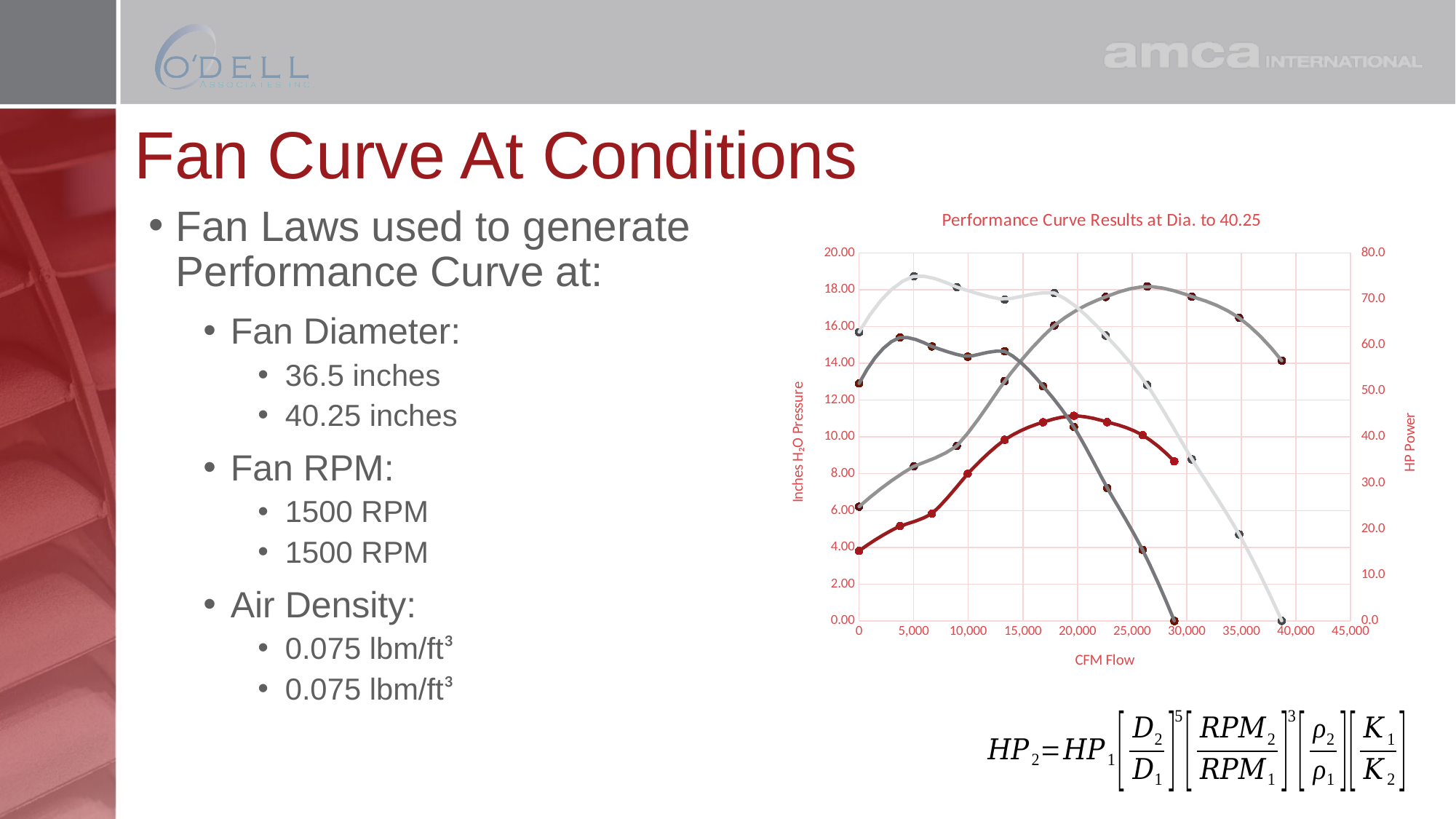
What is the highest value shown on the right vertical axis (HP Power)? 80.0 Does the dark red line end before or after the 30,000 CFM Flow gridline? before Does the dark red line rise or fall between 20,000 and 25,000 CFM Flow? fall Does the dark red line rise or fall between 0 and 15,000 CFM Flow? rise What is the title of the chart? Performance Curve Results at Dia. to 40.25 What is the highest value shown on the left vertical axis (Inches H2O Pressure)? 20.00 How many lines are plotted on the chart? 4 At 5,000 CFM Flow, is the light gray line above or below the 18.00 gridline of the left axis? above What is the label of the horizontal axis of the chart? CFM Flow At 20,000 CFM Flow, is the dark red line above or below the 10.00 gridline of the left axis? above What is the largest CFM Flow value shown on the horizontal axis? 45,000 What kind of chart is shown on the slide? line chart